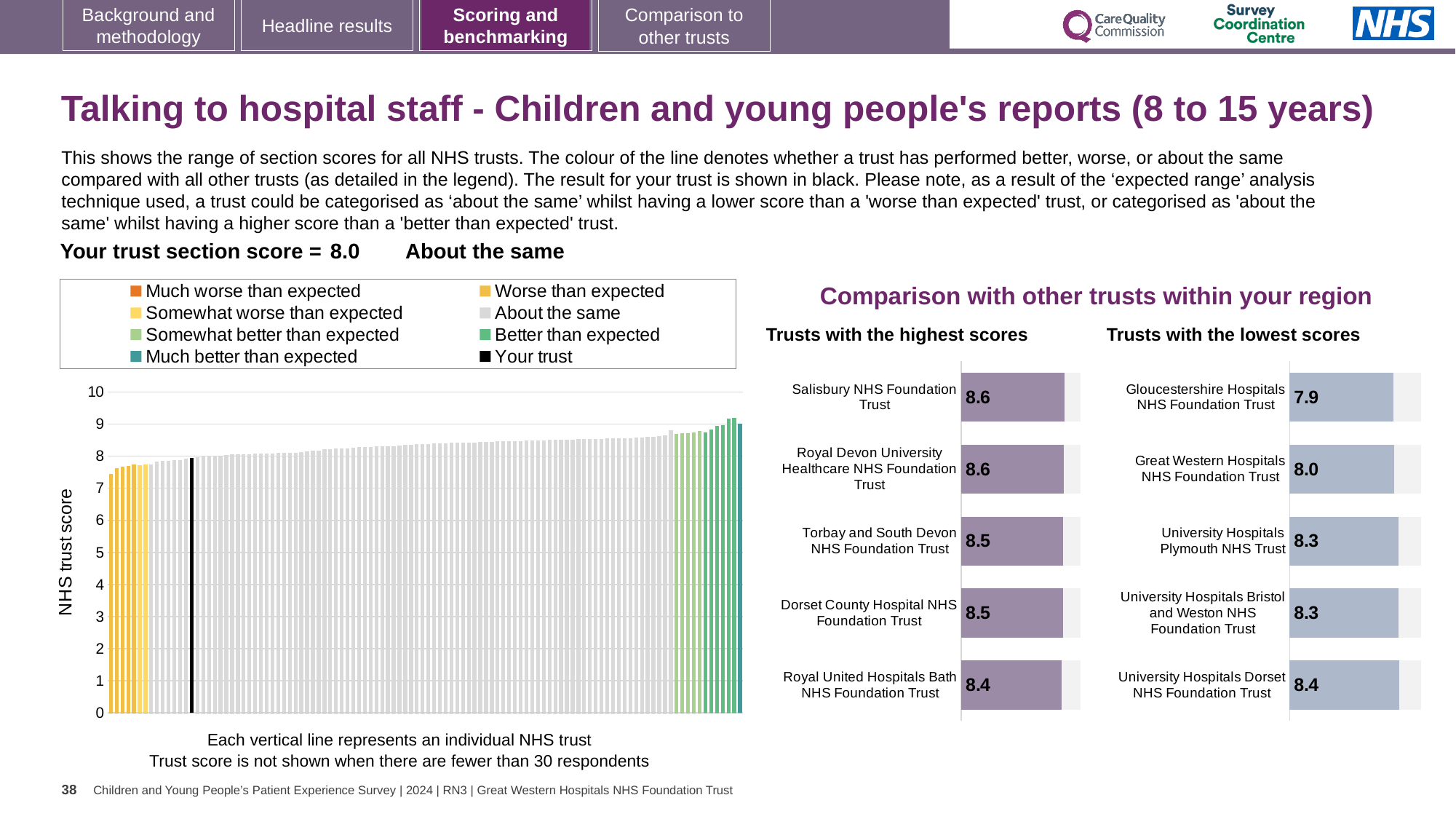
In the 'Trusts with the highest scores' chart, what is the score for Salisbury NHS Foundation Trust? 8.6 In the large chart on the left, do the trust scores rise or fall from left to right? Rise In the 'Trusts with the highest scores' chart, what is the score for Royal United Hospitals Bath NHS Foundation Trust? 8.4 In the 'Trusts with the highest scores' chart, what is the difference between the scores of Salisbury NHS Foundation Trust and Royal United Hospitals Bath NHS Foundation Trust? 0.2 Which has a higher score: Torbay and South Devon NHS Foundation Trust in the highest scores chart, or University Hospitals Plymouth NHS Trust in the lowest scores chart? Torbay and South Devon NHS Foundation Trust How many trusts are listed in the 'Trusts with the highest scores' chart? 5 In the 'Trusts with the lowest scores' chart, what is the score for Gloucestershire Hospitals NHS Foundation Trust? 7.9 In the 'Trusts with the lowest scores' chart, which trust has the highest score? University Hospitals Dorset NHS Foundation Trust In the 'Trusts with the lowest scores' chart, which trust has the lowest score? Gloucestershire Hospitals NHS Foundation Trust In the 'Trusts with the lowest scores' chart, what is the difference between the scores of University Hospitals Dorset NHS Foundation Trust and Gloucestershire Hospitals NHS Foundation Trust? 0.5 In the large chart on the left, is the value of the lowest bar greater or less than 8? less What kind of chart is the large chart on the left showing all NHS trusts? Bar chart